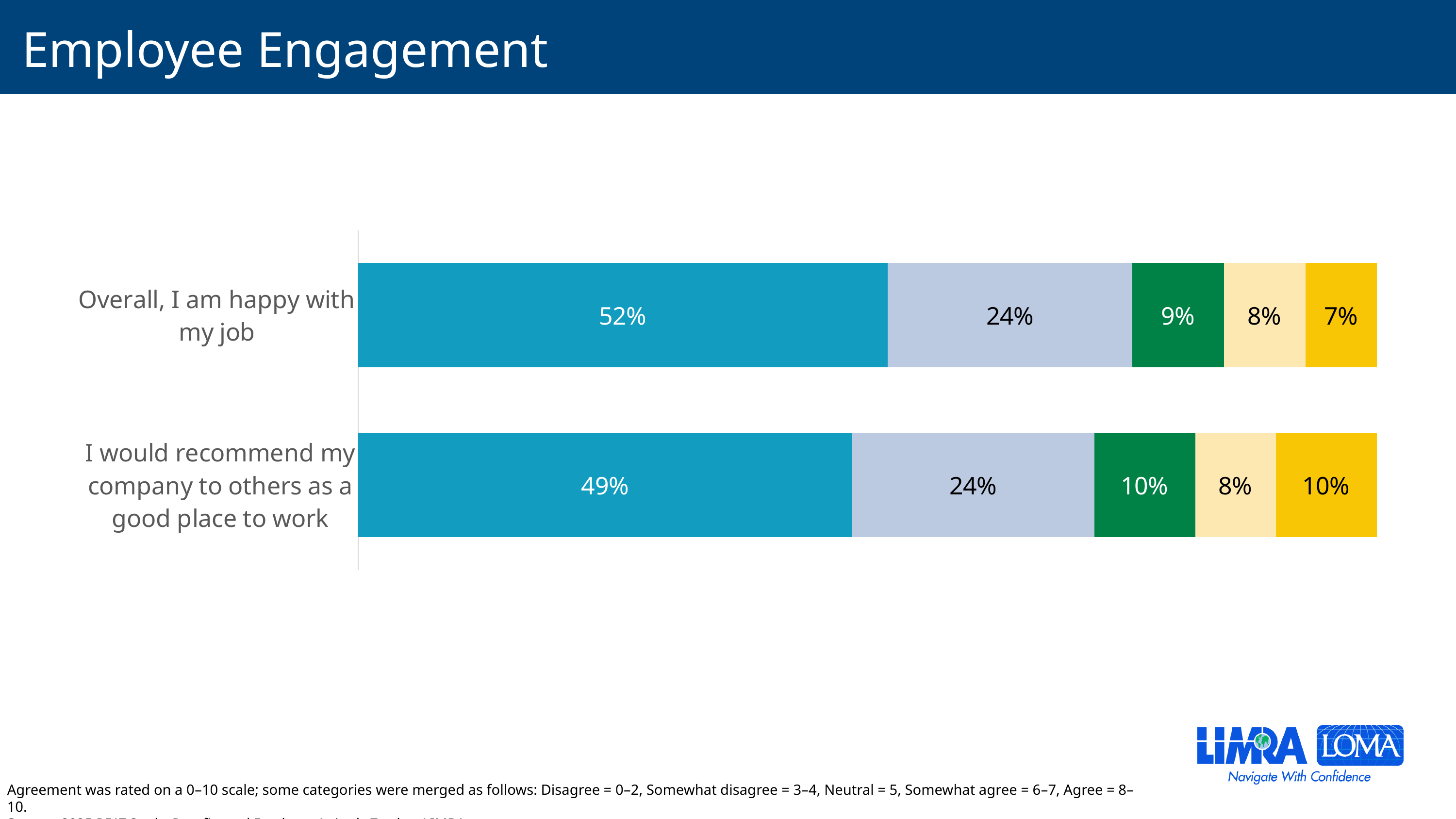
What is the difference between the leftmost (teal) segments of the two statements? 3 percentage points What is the value of the leftmost (teal) segment for "Overall, I am happy with my job"? 52% What is the value of the green segment for "Overall, I am happy with my job"? 9% How many segments make up each bar in the chart? 5 What is the title of the slide containing the chart? Employee Engagement What kind of chart is shown on the slide? stacked bar chart What is the value of the rightmost (yellow) segment for "Overall, I am happy with my job"? 7% What is the value of the rightmost (yellow) segment for "I would recommend my company to others as a good place to work"? 10% What is the smallest segment value in the bar for "Overall, I am happy with my job"? 7% Which statement has the larger leftmost (teal) segment? Overall, I am happy with my job How many categories (statements) are plotted in the chart? 2 What is the value of the leftmost (teal) segment for "I would recommend my company to others as a good place to work"? 49%